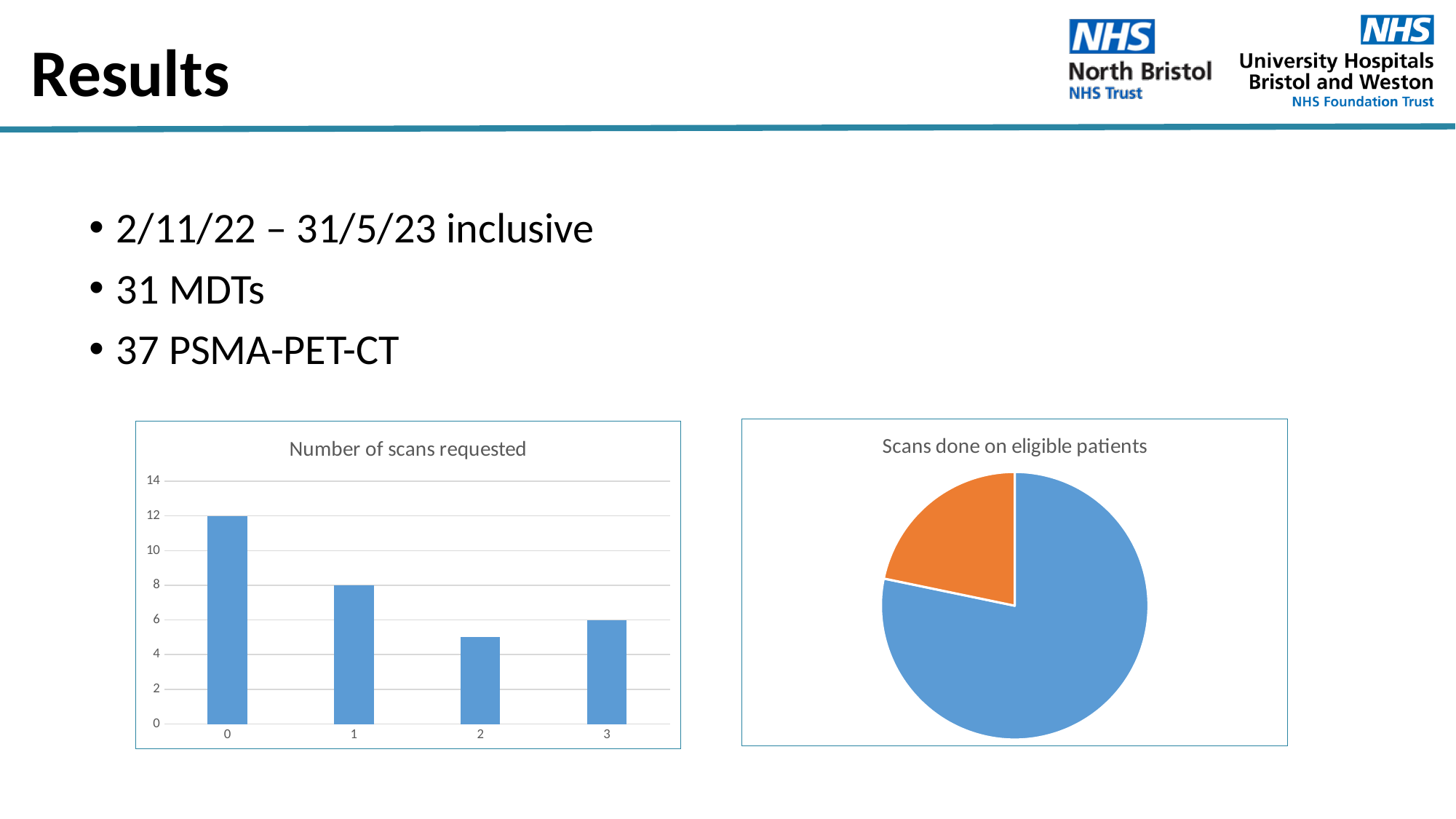
In the 'Number of scans requested' chart, which is larger, the value for category 1 or category 3? category 1 What kind of chart is the 'Number of scans requested' chart? bar chart In the 'Number of scans requested' chart, what is the value for category 1? 8 In the 'Scans done on eligible patients' pie chart, which slice is larger, the blue one or the orange one? blue What kind of chart is the 'Scans done on eligible patients' chart? pie chart In the 'Number of scans requested' chart, which category has the lowest value? 2 How many categories are shown in the 'Number of scans requested' chart? 4 In the 'Number of scans requested' chart, which category has the highest value? 0 In the 'Number of scans requested' chart, what is the value for category 3? 6 In the 'Number of scans requested' chart, what is the difference between the values for category 0 and category 1? 4 In the 'Number of scans requested' chart, is the value for category 2 greater or less than 6? less In the 'Number of scans requested' chart, what is the value for category 0? 12